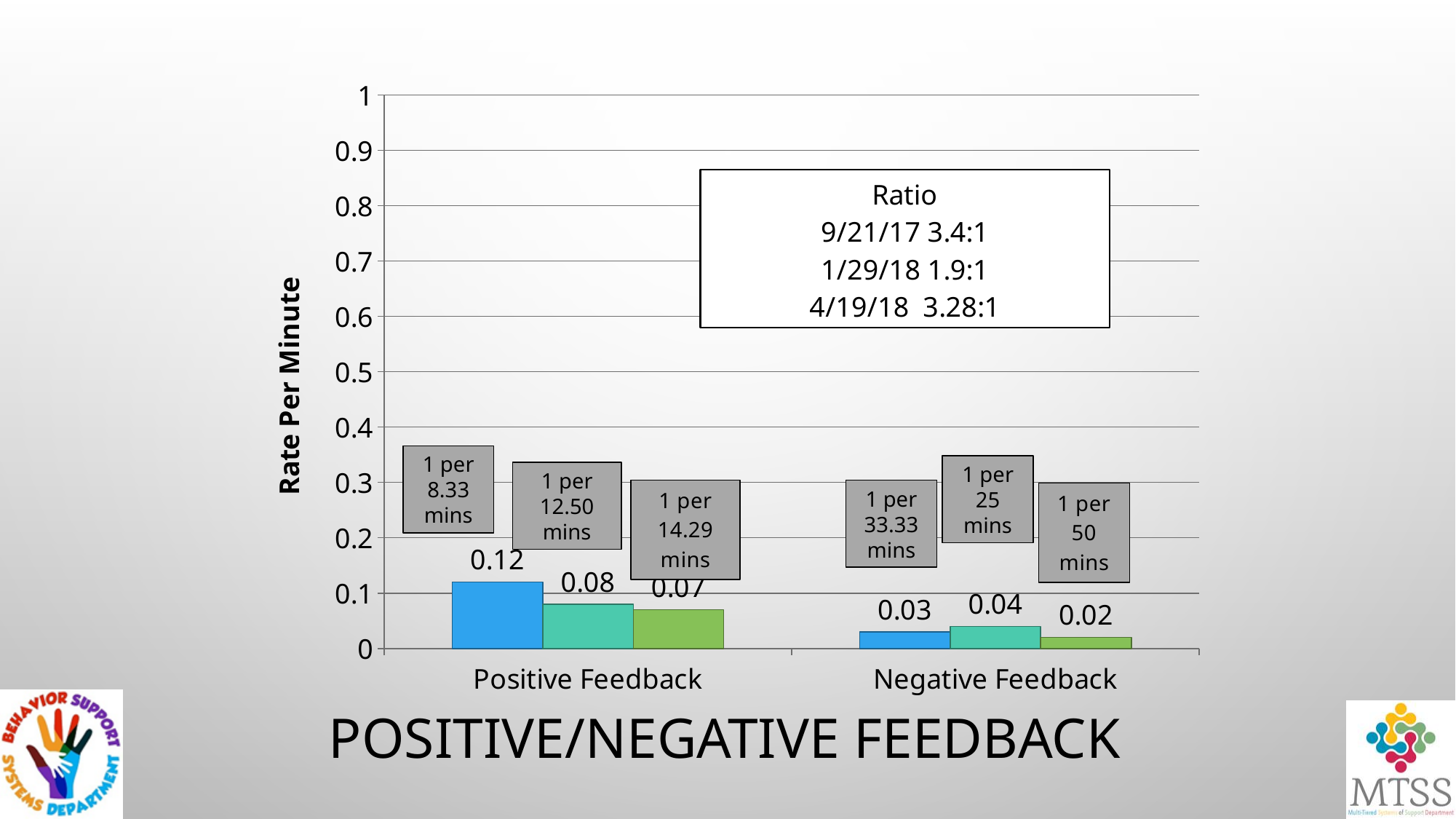
Is the value of the blue bar for Positive Feedback greater or less than 0.1? greater What is the value of the teal bar for Negative Feedback? 0.04 Which bar has the lowest value on the chart? The green bar for Negative Feedback (0.02) Which bar has the highest value on the chart? The blue bar for Positive Feedback (0.12) What is the title of the y axis? Rate Per Minute What is the difference between the blue bar for Positive Feedback and the blue bar for Negative Feedback? 0.09 What is the value of the blue bar for Positive Feedback? 0.12 What is the difference between the teal bar for Positive Feedback and the teal bar for Negative Feedback? 0.04 What is the value of the green bar for Negative Feedback? 0.02 How many categories are shown on the x axis? 2 Which category has the higher blue bar, Positive Feedback or Negative Feedback? Positive Feedback What type of chart is shown on the slide? Bar chart